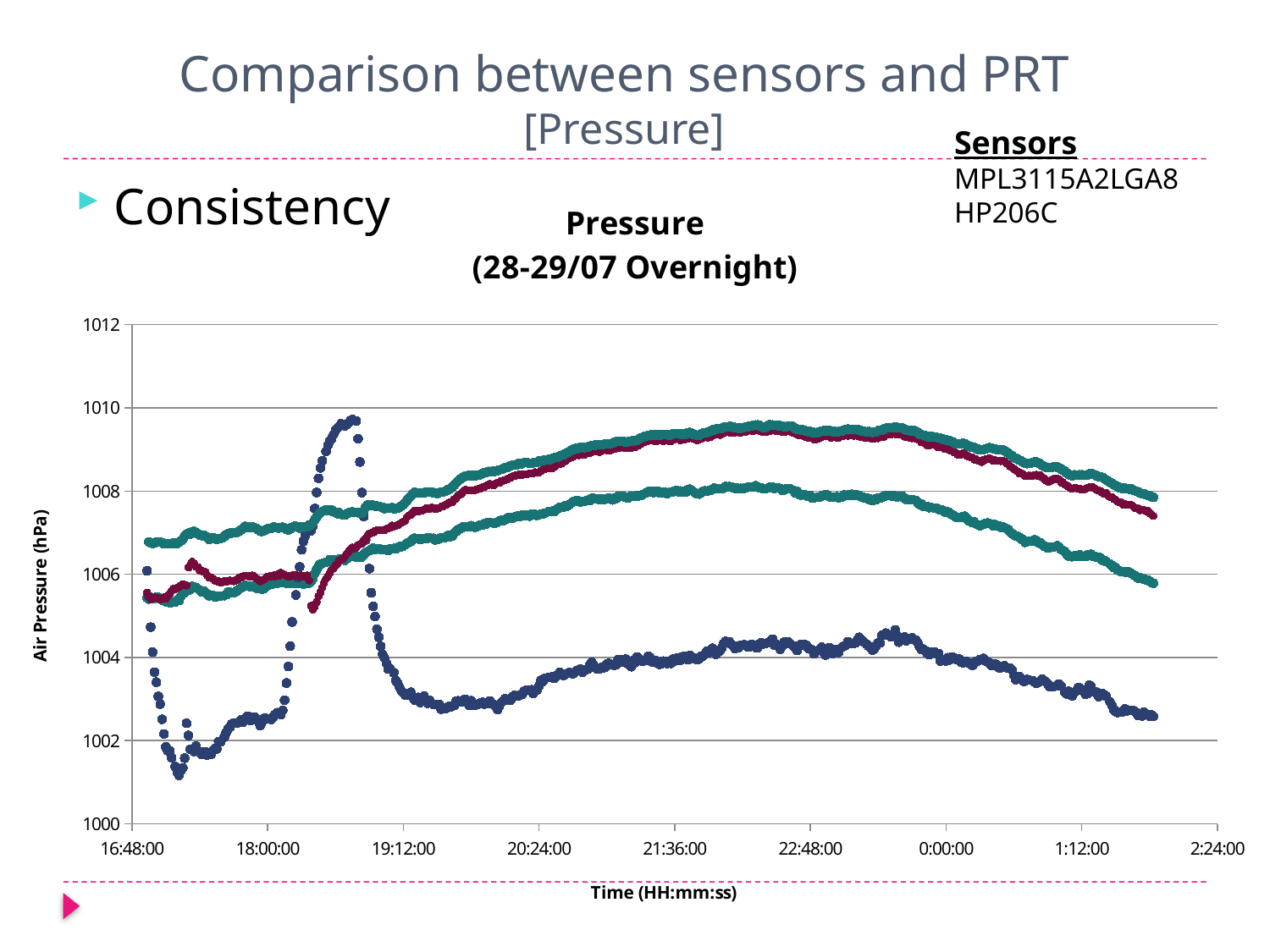
Is the highest pressure value plotted on the chart greater or less than 1010? less What is the lowest value shown on the vertical axis of the chart? 1000 How many time labels are shown on the horizontal axis of the chart? 9 What is the label of the horizontal axis of the chart? Time (HH:mm:ss) What kind of chart is shown on the slide? Scatter chart Is the lowest pressure value plotted on the chart greater or less than 1000? greater What is the first time label on the horizontal axis of the chart? 16:48:00